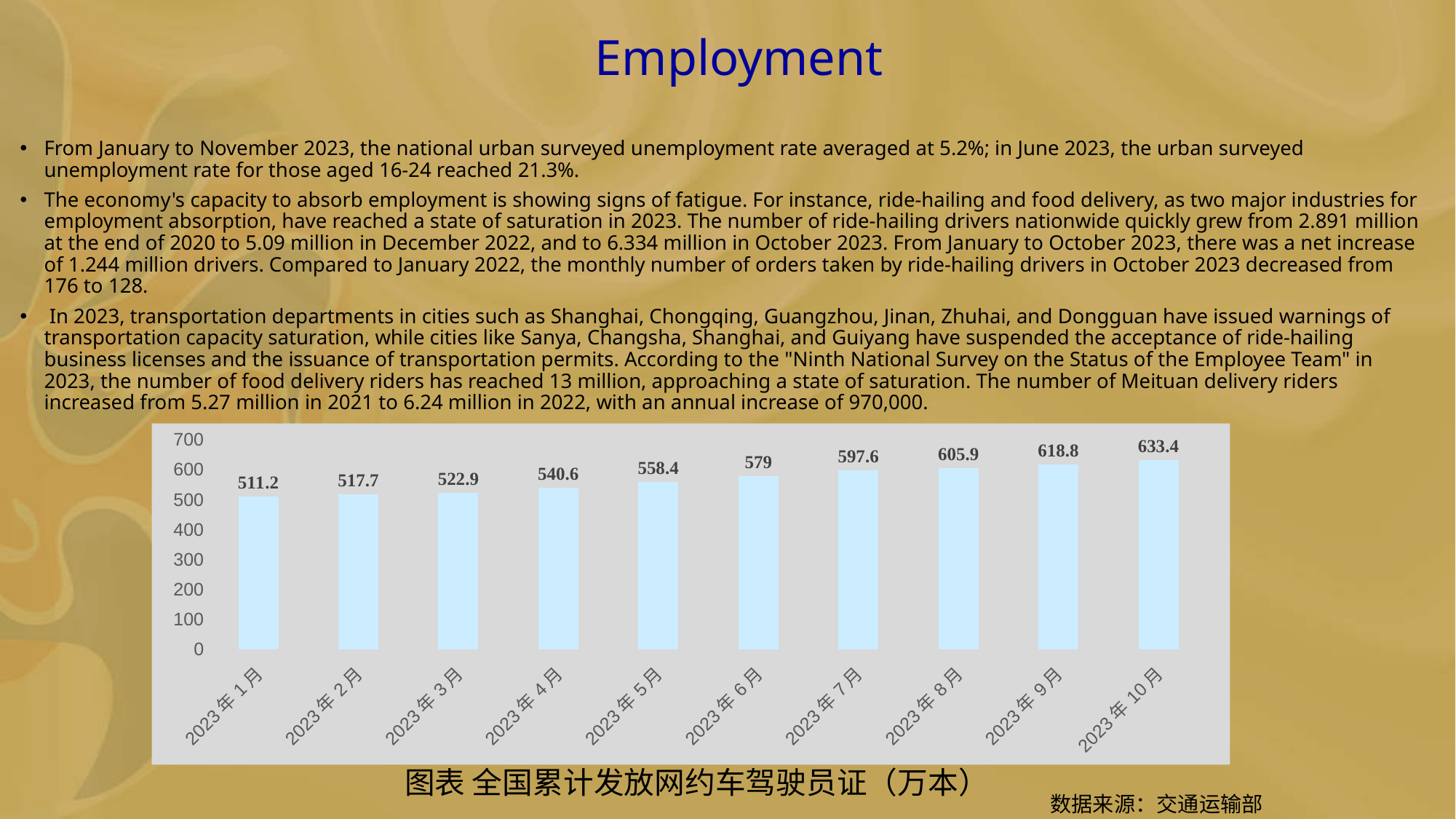
Which month has the lowest value? 2023年1月 Do the values rise or fall from 2023年1月 to 2023年10月? rise Which month has the highest value? 2023年10月 What is the value for 2023年1月? 511.2 What is the difference between the values for 2023年5月 and 2023年4月? 17.8 How many months are shown on the chart? 10 Is the value for 2023年9月 greater or less than 600? greater What is the value for 2023年10月? 633.4 What is the value for 2023年6月? 579 What is the difference between the values for 2023年10月 and 2023年1月? 122.2 What kind of chart is shown on the slide? bar chart Which is larger, the value for 2023年8月 or 2023年7月? 2023年8月